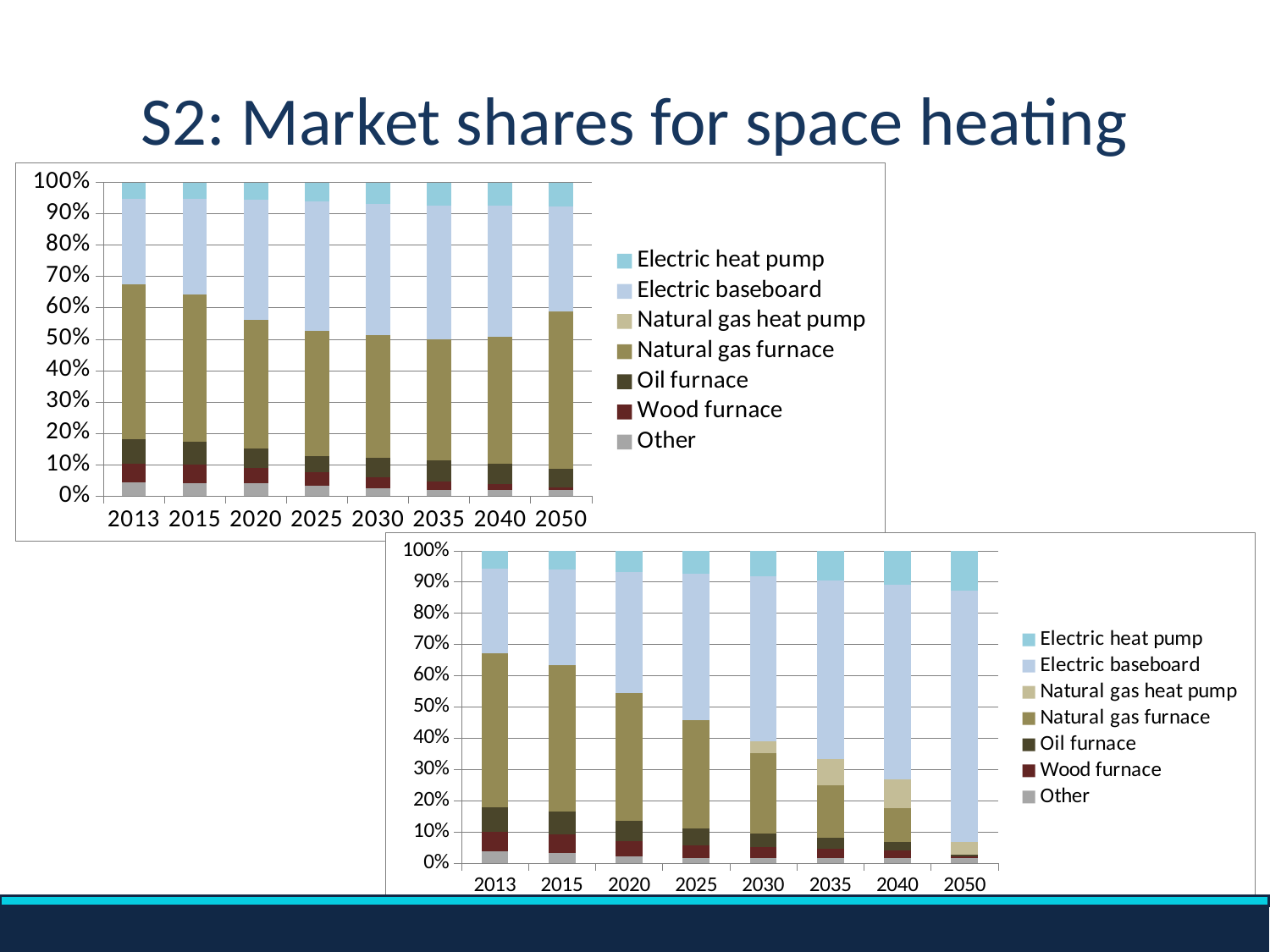
What is the title of the slide? S2: Market shares for space heating In the lower chart, which year has the largest Natural gas furnace share? 2013 Which series is listed first in the legend of the upper chart? Electric heat pump In the lower chart, which year has the largest Electric baseboard share? 2050 In the lower chart, does the share of Electric baseboard rise or fall from 2013 to 2050? rise What kind of chart is the upper chart on the slide? stacked bar chart In the lower chart, is the cumulative share up to the top of the Natural gas furnace segment in 2035 greater or less than 30%? less In the upper chart, is the cumulative share up to the top of the Natural gas furnace segment in 2050 greater or less than 50%? greater How many years are shown on the x axis of the upper chart? 8 In the lower chart, is the cumulative share up to the top of the Natural gas furnace segment in 2013 greater or less than 60%? greater How many series does the legend of the lower chart list? 7